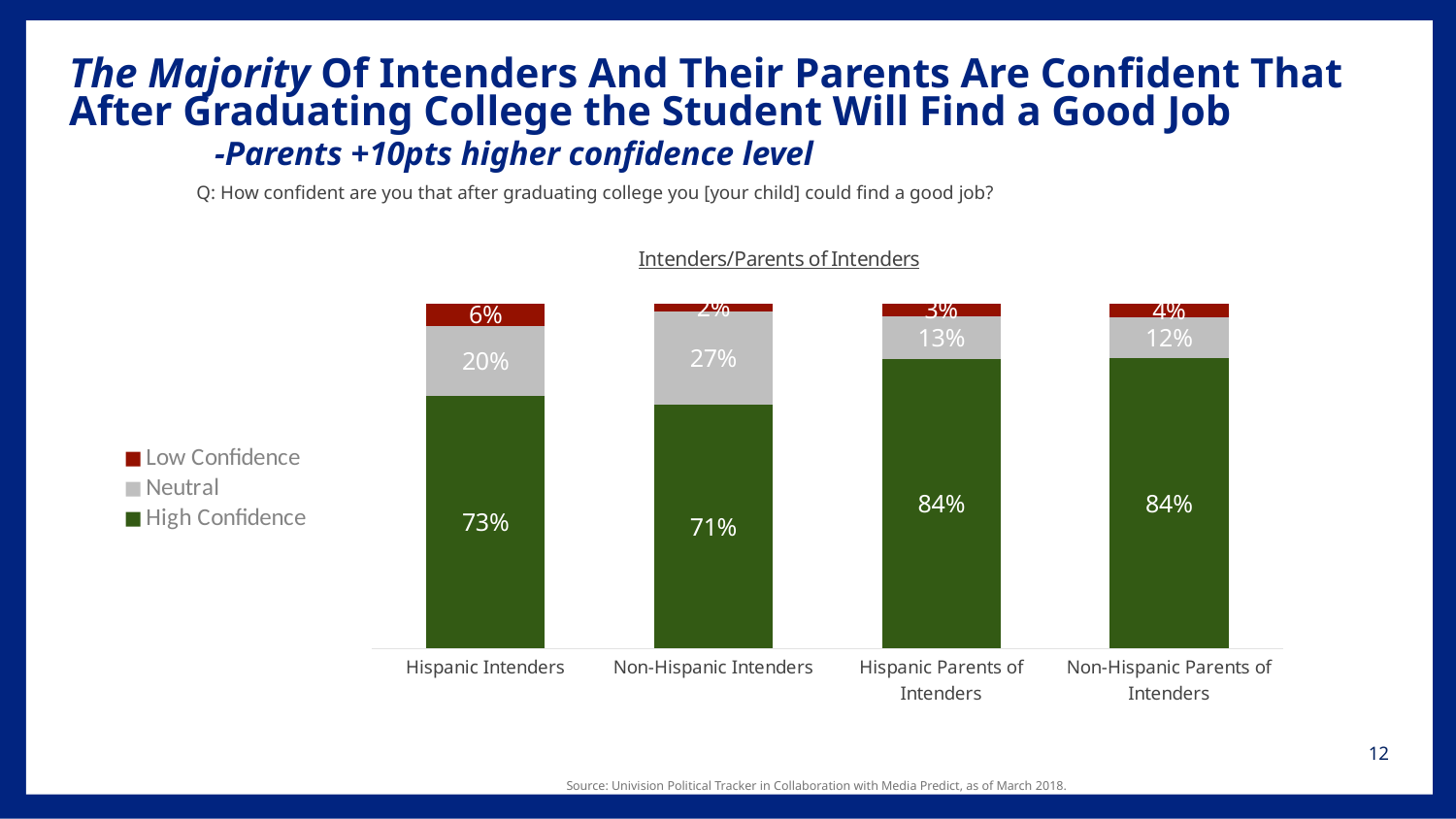
How many series does the legend list? 3 What is the Low Confidence value for Non-Hispanic Parents of Intenders? 4% What is the difference between the High Confidence values for Hispanic Parents of Intenders and Hispanic Intenders? 11% Which category has the highest Neutral value? Non-Hispanic Intenders What is the total of the stacked bar for Hispanic Intenders? 99% What is the High Confidence value for Hispanic Intenders? 73% How many categories are shown on the x axis? 4 Which is larger, the Low Confidence value for Hispanic Intenders or for Non-Hispanic Intenders? Hispanic Intenders What kind of chart is shown on the slide? Stacked bar chart Which category has the lowest High Confidence value? Non-Hispanic Intenders What is the Neutral value for Non-Hispanic Intenders? 27% What is the Neutral value for Hispanic Parents of Intenders? 13%